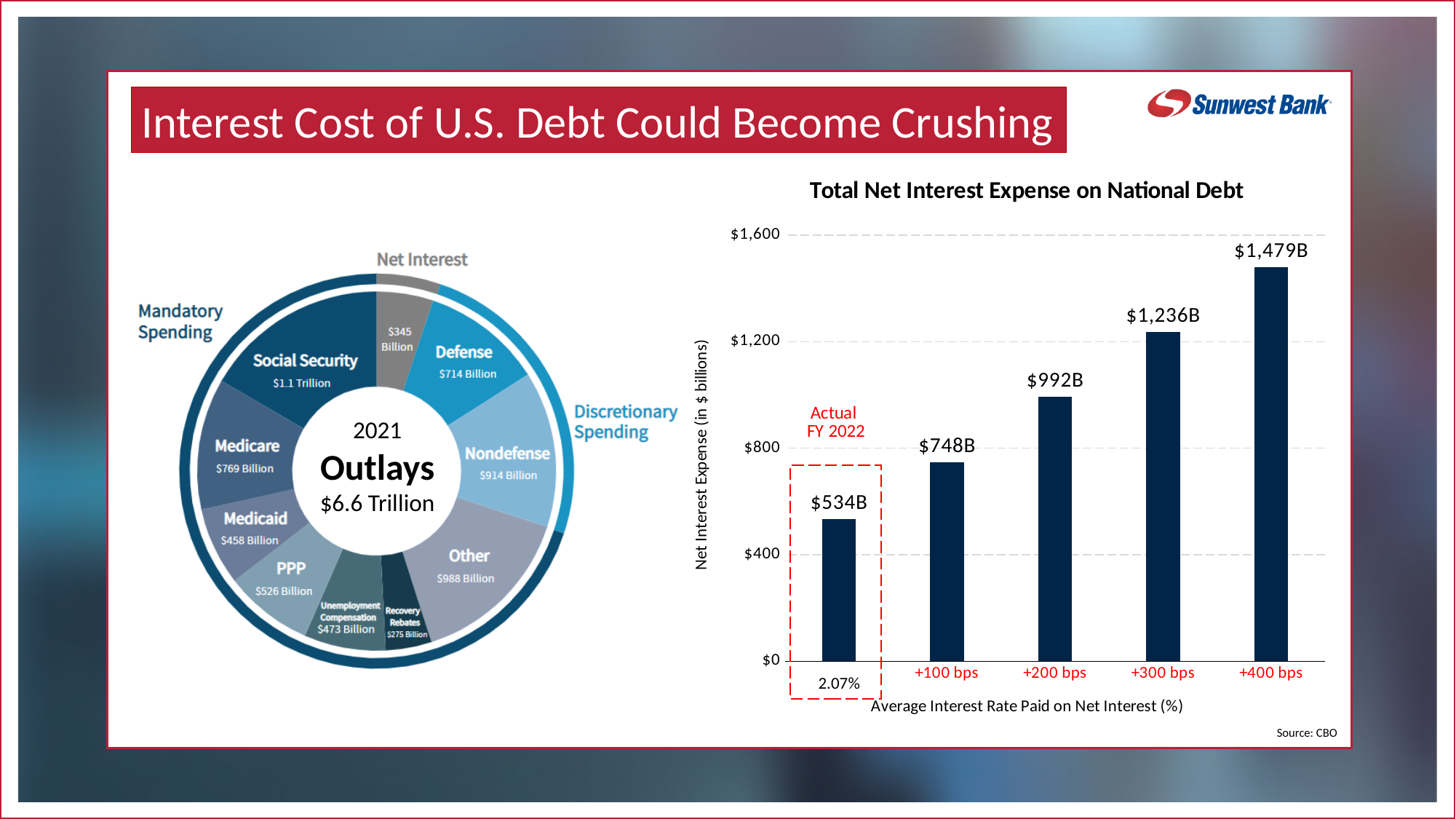
In the 'Total Net Interest Expense on National Debt' chart, what is the difference between the +400 bps value and the +300 bps value? $243B In the 2021 Outlays donut chart on the left, which is larger, Defense or Nondefense? Nondefense What kind of chart is 'Total Net Interest Expense on National Debt'? bar chart In the 'Total Net Interest Expense on National Debt' chart, what is the value for the actual FY 2022 bar at 2.07%? $534B In the 'Total Net Interest Expense on National Debt' chart, which category has the highest value? +400 bps In the 'Total Net Interest Expense on National Debt' chart, do the values rise or fall as the interest rate increases along the x axis? rise In the 2021 Outlays donut chart on the left, what is the value for Medicare? $769 Billion How many bars are in the 'Total Net Interest Expense on National Debt' chart? 5 In the 'Total Net Interest Expense on National Debt' chart, which category has the lowest value? 2.07% What is the x-axis label of the 'Total Net Interest Expense on National Debt' chart? Average Interest Rate Paid on Net Interest (%) In the 'Total Net Interest Expense on National Debt' chart, is the value for +100 bps greater or less than $800? less In the 'Total Net Interest Expense on National Debt' chart, what is the value for +200 bps? $992B